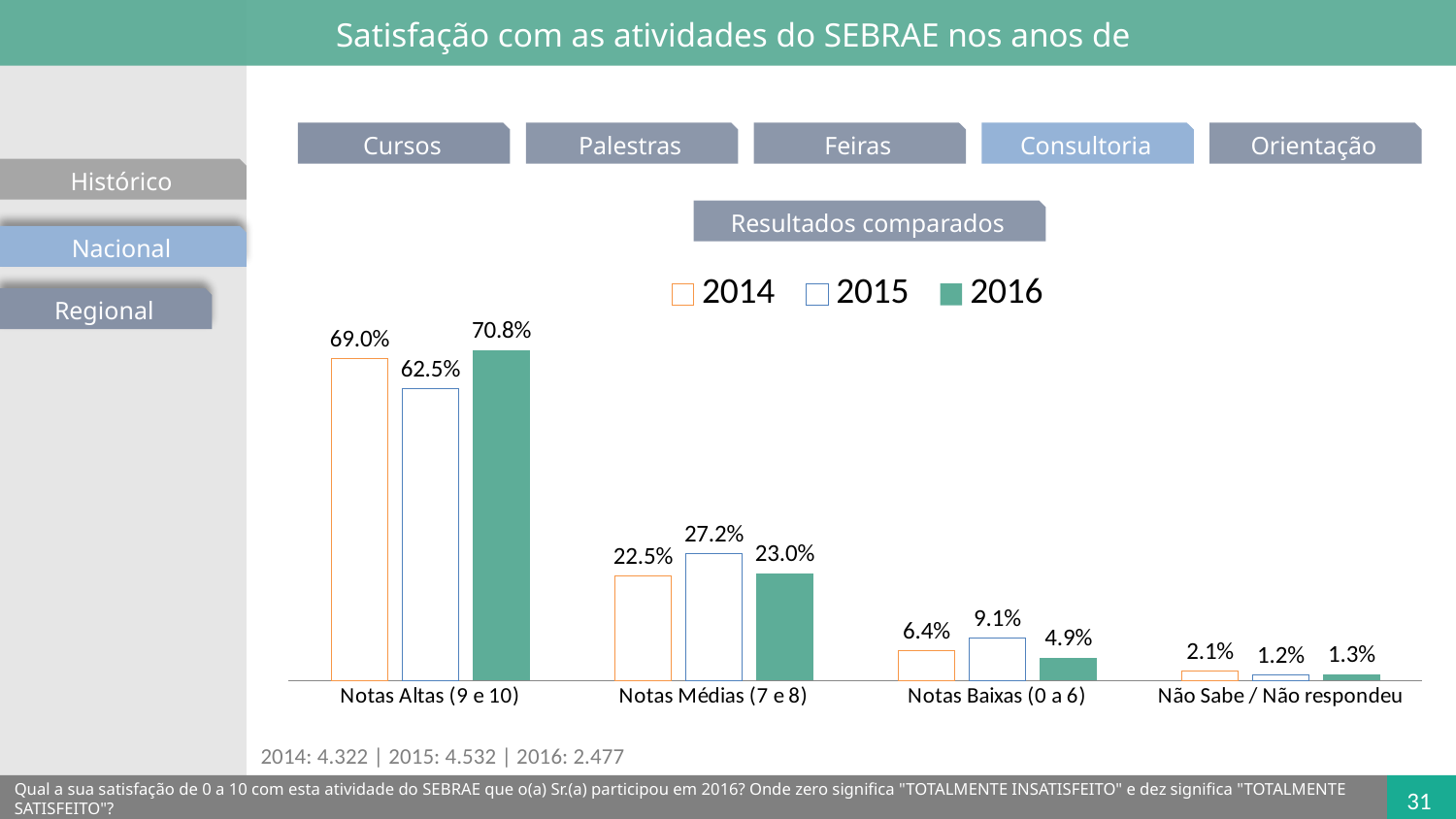
Which series is shown with solid green bars in the legend? 2016 How many categories are shown on the x axis? 4 What kind of chart is shown on the slide? Bar chart What is the difference between the 2016 and 2015 values for Notas Altas (9 e 10)? 8.3% Which category has the lowest 2014 value? Não Sabe / Não respondeu Which category has the highest 2016 value? Notas Altas (9 e 10) What was the 2016 value for Notas Altas (9 e 10)? 70.8% Which is larger for Notas Baixas (0 a 6): the 2015 value or the 2016 value? 2015 What was the 2015 value for Notas Médias (7 e 8)? 27.2% How many series does the legend list? 3 What was the 2015 value for Não Sabe / Não respondeu? 1.2% What was the 2014 value for Notas Baixas (0 a 6)? 6.4%